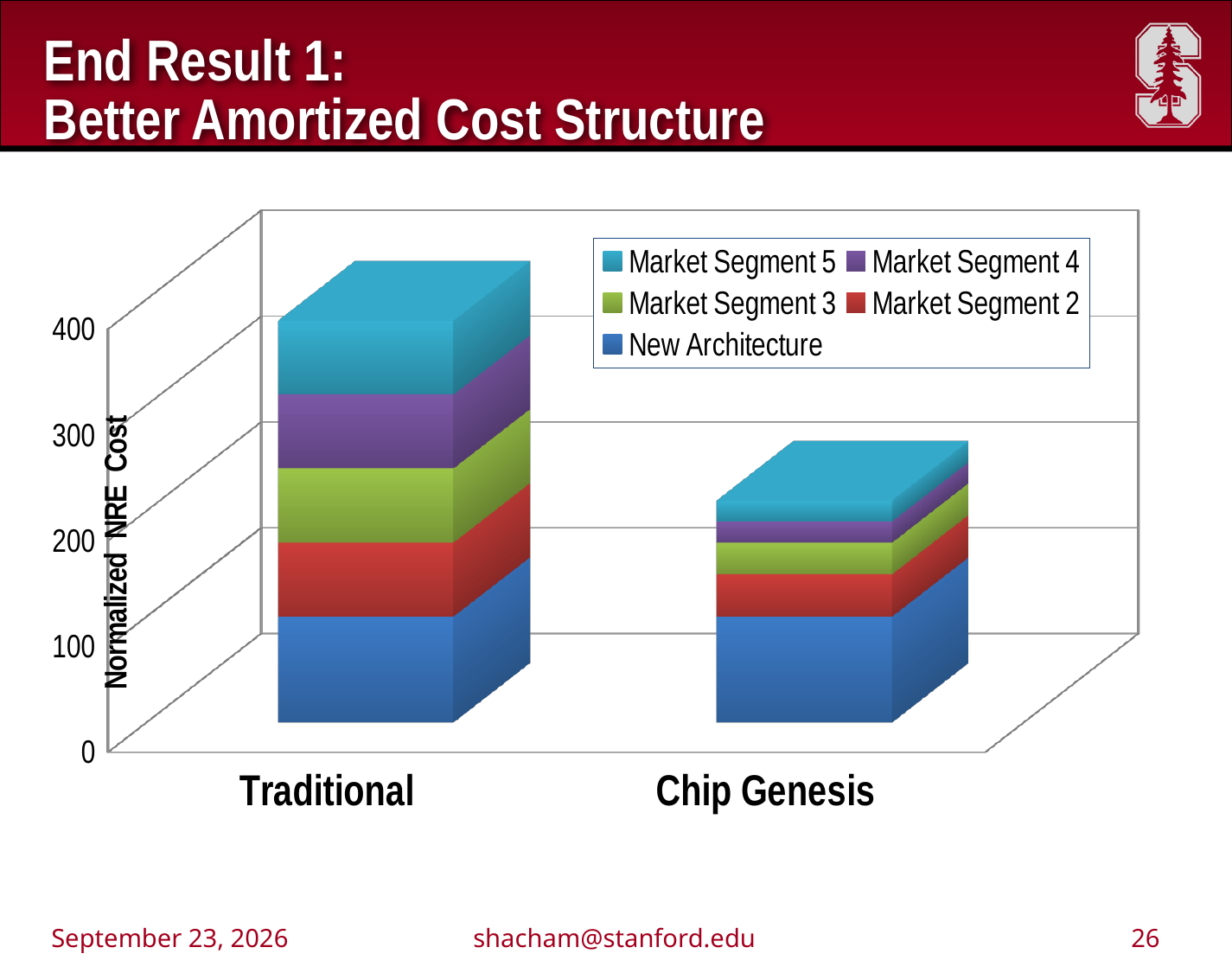
Is the Market Segment 5 segment larger for Traditional or for Chip Genesis? Traditional How many series does the chart's legend list? 5 What kind of chart is shown on the slide? stacked bar chart What is the title of the chart's vertical axis? Normalized NRE Cost How many categories are shown on the x axis of the chart? 2 Which stacked bar is taller, Traditional or Chip Genesis? Traditional Which series is shown in blue at the bottom of each stacked bar? New Architecture Which category has the lowest total Normalized NRE Cost? Chip Genesis Is the total value for Traditional greater or less than 300? greater Is the Market Segment 4 segment larger for Traditional or for Chip Genesis? Traditional Is the total value for Chip Genesis greater or less than 300? less Which category has the highest total Normalized NRE Cost? Traditional